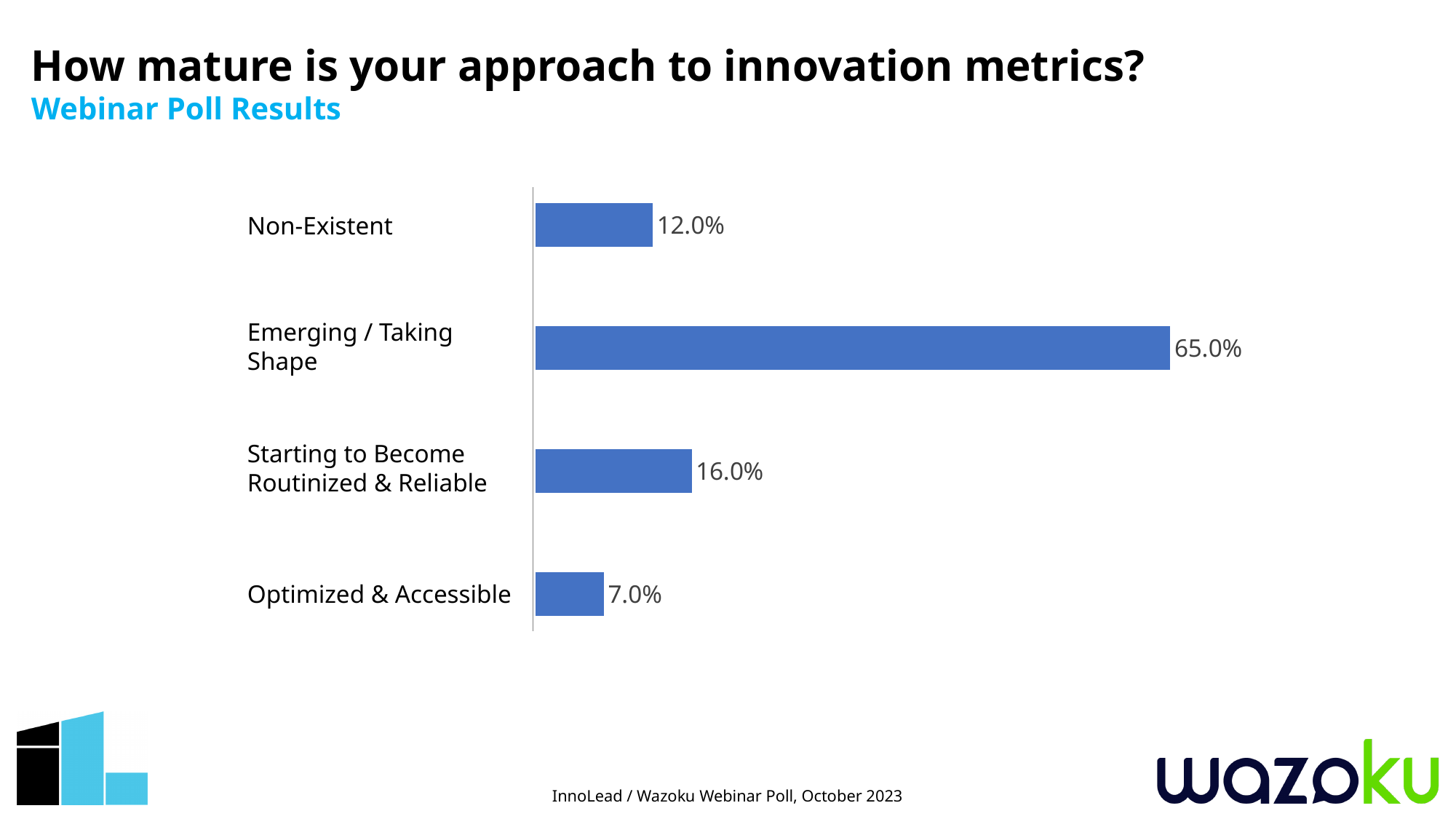
What is the title of the slide containing the chart? How mature is your approach to innovation metrics? Which category has the lowest value? Optimized & Accessible What is the difference between the values for "Emerging / Taking Shape" and "Starting to Become Routinized & Reliable"? 49.0% How many categories are shown in the chart? 4 What is the difference between the values for "Non-Existent" and "Optimized & Accessible"? 5.0% What percentage of respondents answered "Optimized & Accessible"? 7.0% Which is larger, the value for "Non-Existent" or the value for "Starting to Become Routinized & Reliable"? Starting to Become Routinized & Reliable What is the value for "Emerging / Taking Shape"? 65.0% What kind of chart is shown on the slide? Bar chart What percentage of respondents answered "Non-Existent"? 12.0% What is the value for "Starting to Become Routinized & Reliable"? 16.0% Which category has the highest value? Emerging / Taking Shape